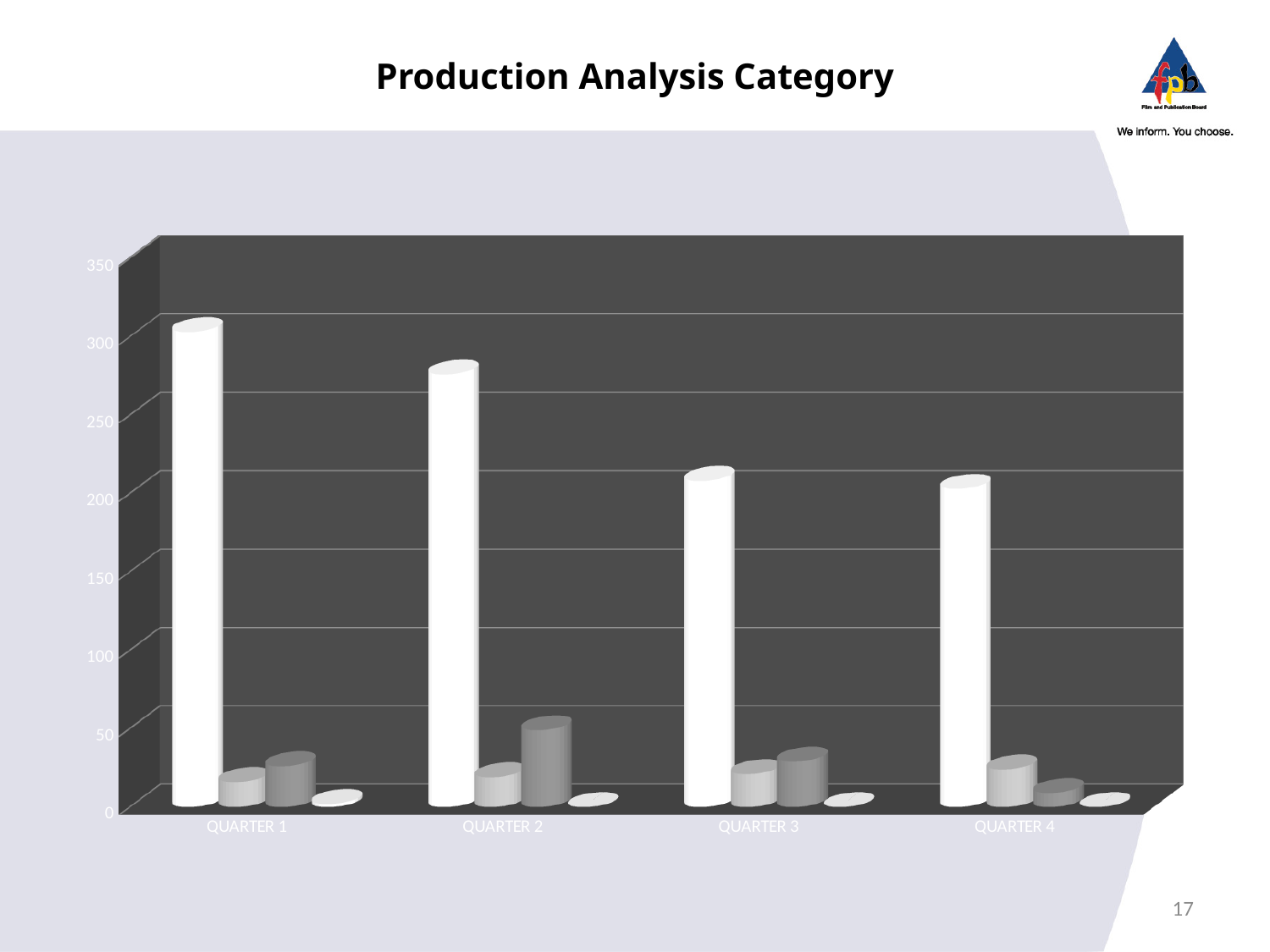
Is the tallest bar for Quarter 4 greater or less than 150? greater What kind of chart is shown on the slide? bar chart Which quarter has the tallest bar in the chart? Quarter 1 Which is taller: the tallest bar for Quarter 1 or the tallest bar for Quarter 2? Quarter 1 Is the tallest bar for Quarter 1 greater or less than 250? greater Does the tallest bar in each quarter rise or fall from Quarter 1 to Quarter 4? fall Which is taller: the tallest bar for Quarter 2 or the tallest bar for Quarter 3? Quarter 2 How many bars are plotted for each quarter in the chart? 4 What is the title of the slide containing the chart? Production Analysis Category Is the tallest bar for Quarter 3 greater or less than 250? less How many quarters are shown on the x axis of the chart? 4